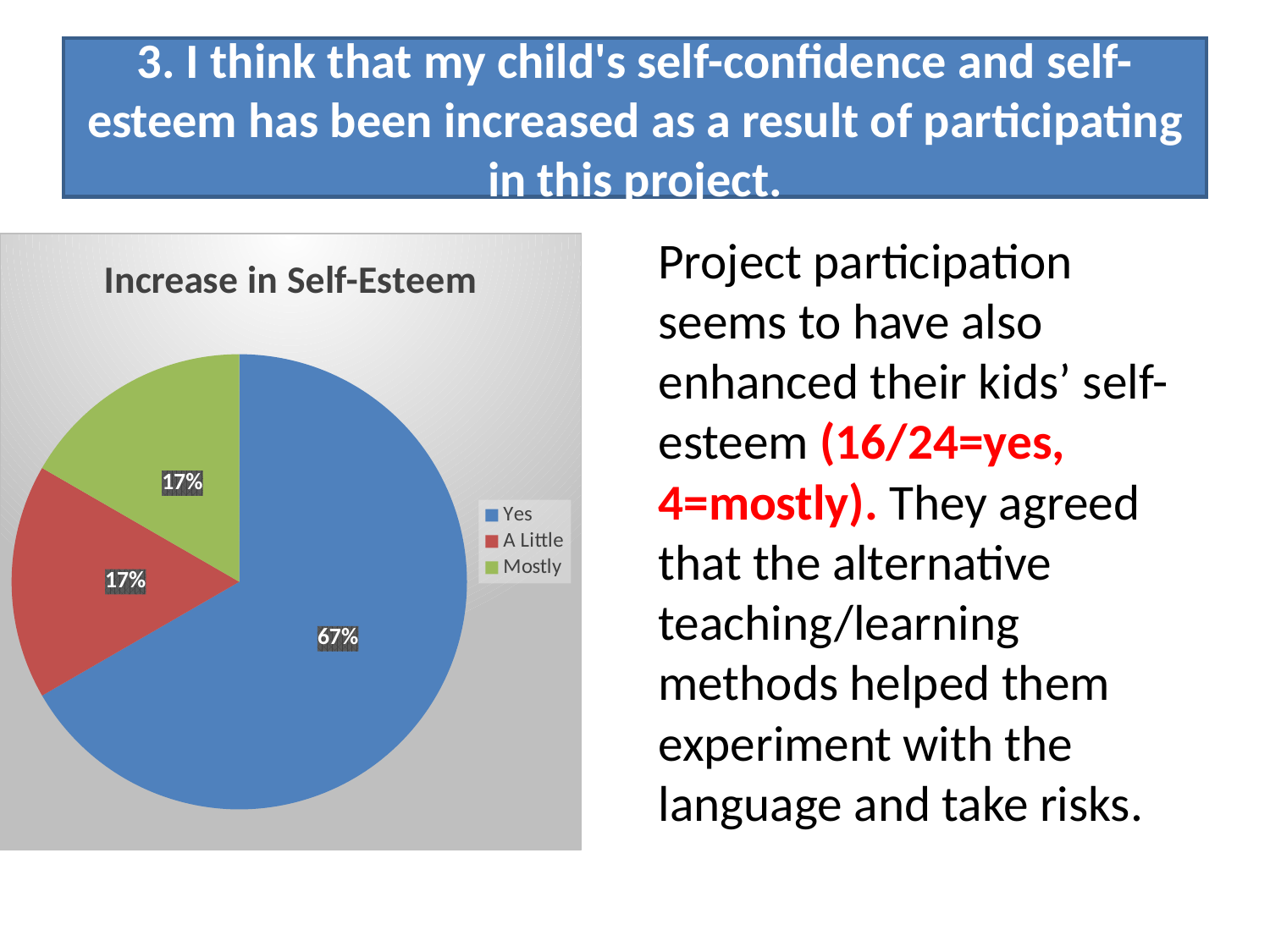
What percentage of the pie is labelled for the "Yes" slice? 67% How many slices does the pie chart have? 3 What percentage of the pie is labelled for the "A Little" slice? 17% What is the difference in percentage points between the "Yes" slice and the "A Little" slice? 50 Which category has the largest share of the pie? Yes Is the share for "Yes" greater or less than 50%? greater Is the share for "Yes" larger or smaller than the share for "Mostly"? larger What percentage of the pie is labelled for the "Mostly" slice? 17% What type of chart is shown on the slide? pie chart How many entries does the legend list? 3 Which colour represents the "Yes" category in the pie chart? blue What is the title of the chart? Increase in Self-Esteem